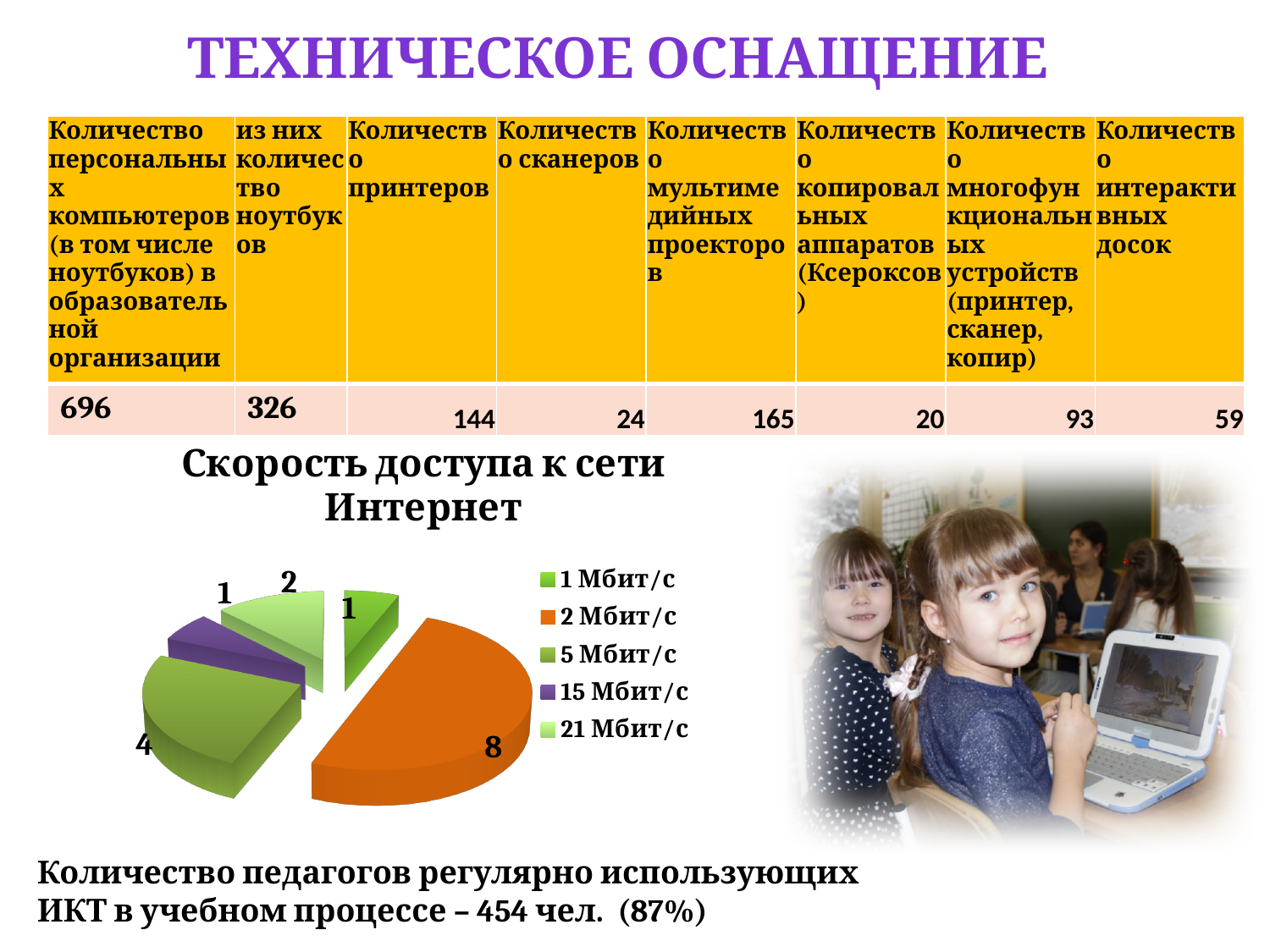
In the pie chart, what is the value for 15 Мбит/с? 1 What kind of chart is shown under the title "Скорость доступа к сети Интернет"? pie chart What share of the pie chart does the 2 Мбит/с slice represent? 50% In the pie chart, what is the value for 21 Мбит/с? 2 In the pie chart, which is larger: the value for 5 Мбит/с or the value for 21 Мбит/с? 5 Мбит/с How many categories does the legend of the pie chart list? 5 In the pie chart, what is the value for 5 Мбит/с? 4 What is the difference between the values for 2 Мбит/с and 5 Мбит/с in the pie chart? 4 Which category has the largest slice in the pie chart? 2 Мбит/с What colour is the 2 Мбит/с slice in the pie chart? orange What is the total of all the values shown in the pie chart? 16 In the pie chart, what is the value for 2 Мбит/с? 8